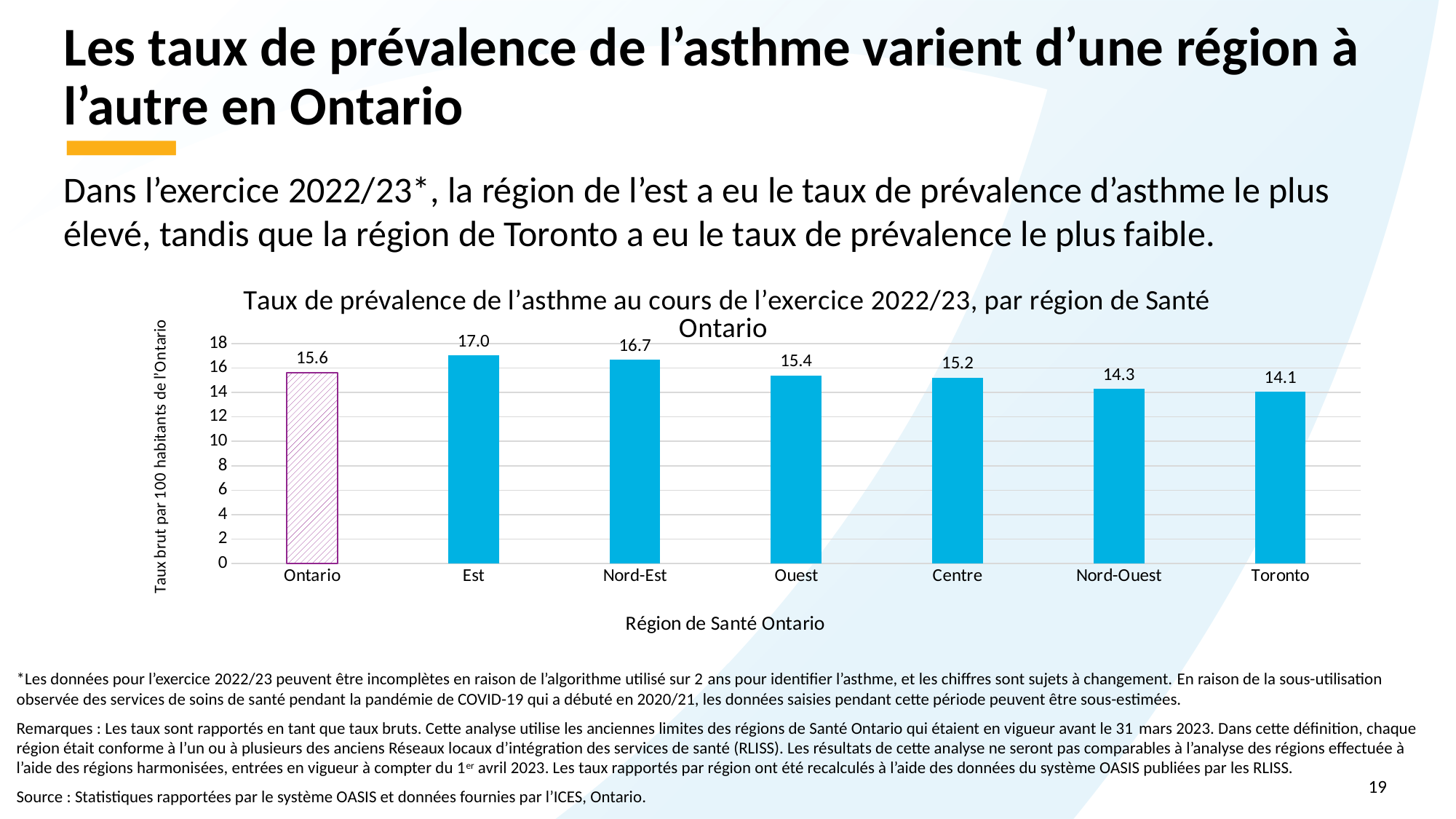
Which has a higher rate, Centre or Nord-Ouest? Centre Is the value for Ouest greater or less than 16? less What is the asthma prevalence rate for Toronto? 14.1 Which region has the lowest asthma prevalence rate? Toronto What is the asthma prevalence rate for the Est region? 17.0 What is the label of the x axis? Région de Santé Ontario What kind of chart is shown on the slide? Bar chart What is the value shown for Ontario overall? 15.6 What is the difference between the rates for Est and Toronto? 2.9 What is the difference between the Nord-Est rate and the Ontario rate? 1.1 Which region has the highest asthma prevalence rate? Est How many bars are shown in the chart? 7